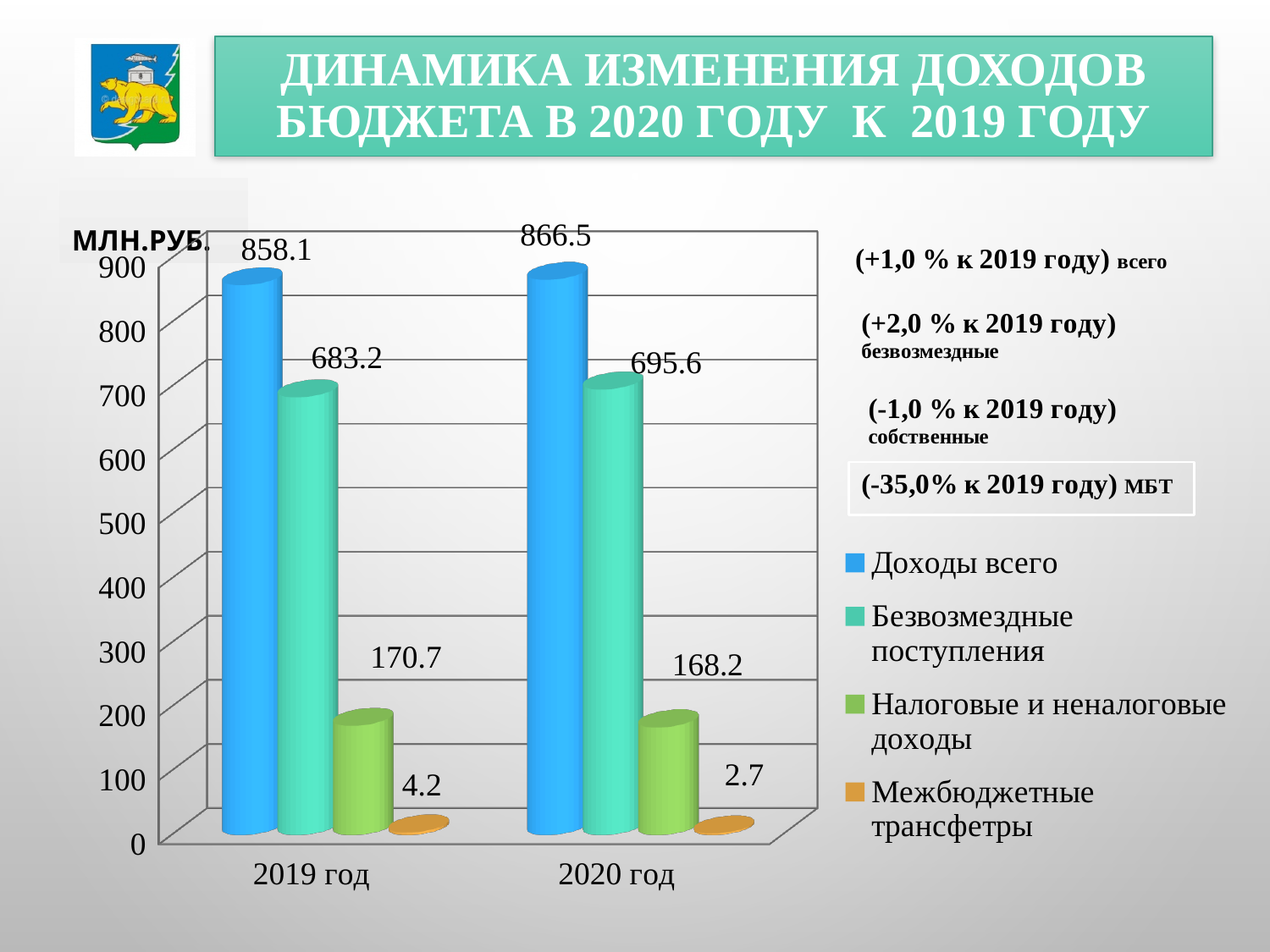
What is the difference between Доходы всего in 2020 год and in 2019 год? 8.4 What kind of chart is shown on the slide? Bar chart What is the value of Доходы всего for 2019 год? 858.1 Which series has the highest value in 2020 год? Доходы всего How many categories are shown on the x axis? 2 How many series does the legend list? 4 Which is larger: Налоговые и неналоговые доходы in 2019 год or in 2020 год? 2019 год What is the value of Налоговые и неналоговые доходы for 2019 год? 170.7 What is the value of Безвозмездные поступления for 2020 год? 695.6 What unit is indicated for the values on the chart? МЛН.РУБ. What is the value of Межбюджетные трансфетры for 2020 год? 2.7 Which series has the lowest value in 2019 год? Межбюджетные трансфетры